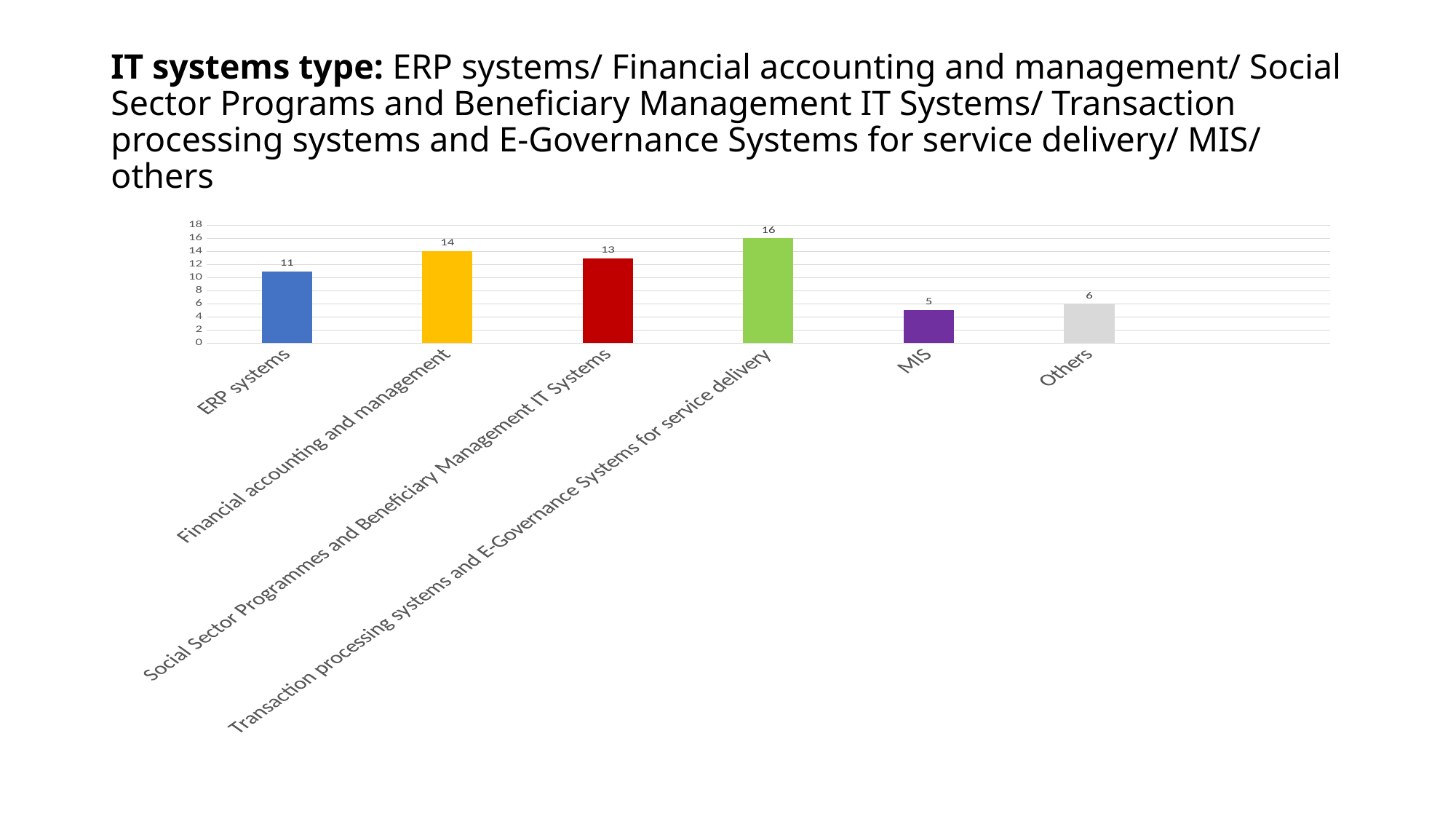
What colour is the bar for MIS? Purple What is the value for MIS? 5 What is the difference between the values for Others and MIS? 1 What is the value for Financial accounting and management? 14 Which category has the lowest value? MIS Which is larger, the value for Financial accounting and management or the value for Social Sector Programmes and Beneficiary Management IT Systems? Financial accounting and management What kind of chart is shown on the slide? Bar chart How many categories are shown in the chart? 6 What is the difference between the values for Transaction processing systems and E-Governance Systems for service delivery and ERP systems? 5 What is the value for Others? 6 Which category has the highest value? Transaction processing systems and E-Governance Systems for service delivery What is the value for ERP systems? 11